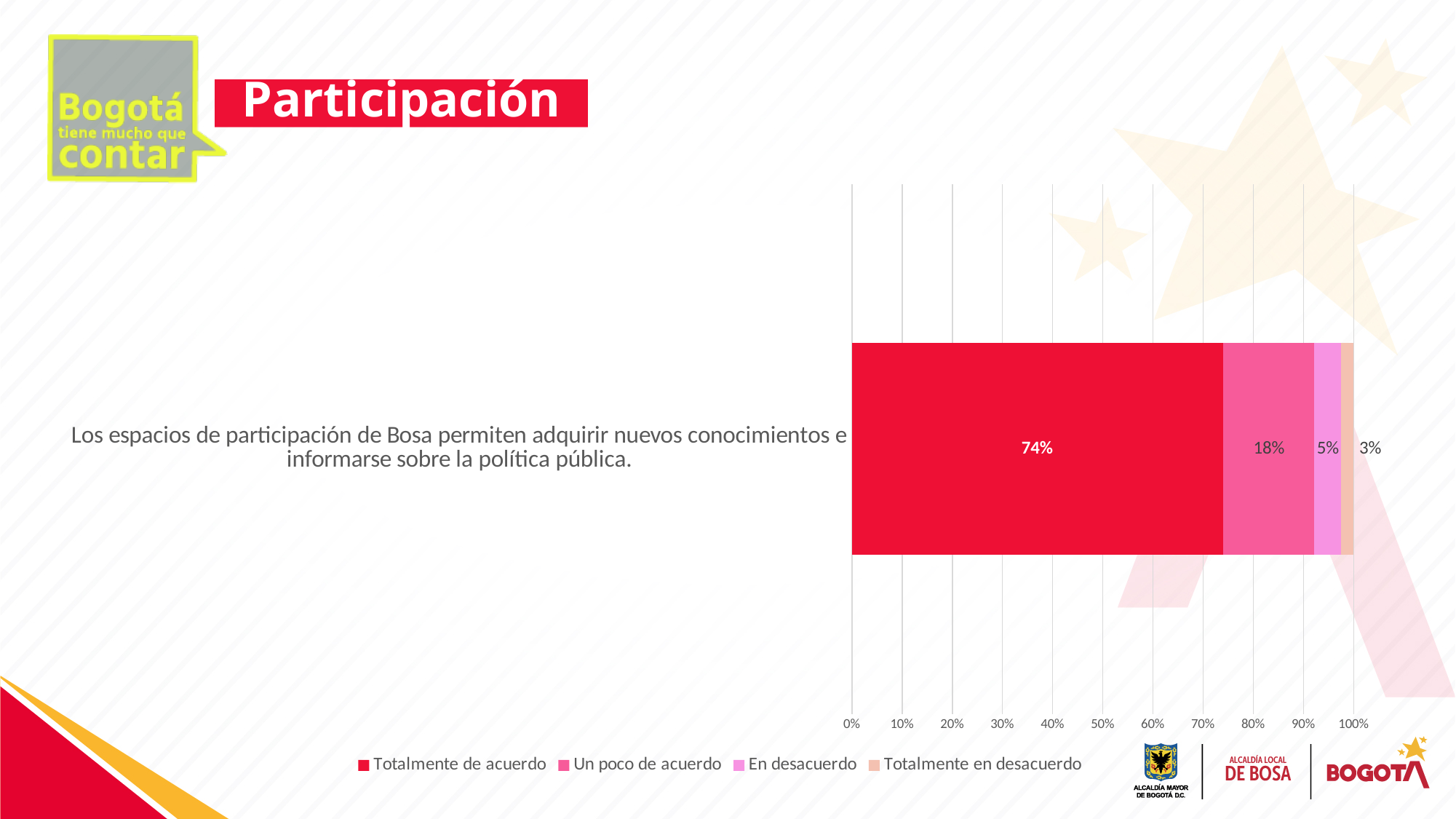
What percentage of respondents answered "Totalmente en desacuerdo"? 3% What percentage of respondents answered "En desacuerdo"? 5% Which response option has the highest share? Totalmente de acuerdo Which is larger, the share for "En desacuerdo" or for "Totalmente en desacuerdo"? En desacuerdo What kind of chart is shown on the slide? Stacked bar chart What percentage of respondents answered "Un poco de acuerdo"? 18% What is the total of the stacked bar? 100% How many series does the legend list? 4 What percentage of respondents answered "Totalmente de acuerdo"? 74% Which response option has the lowest share? Totalmente en desacuerdo What is the difference between the "Totalmente de acuerdo" and "Un poco de acuerdo" shares? 56% What colour is the "Totalmente de acuerdo" segment? Red